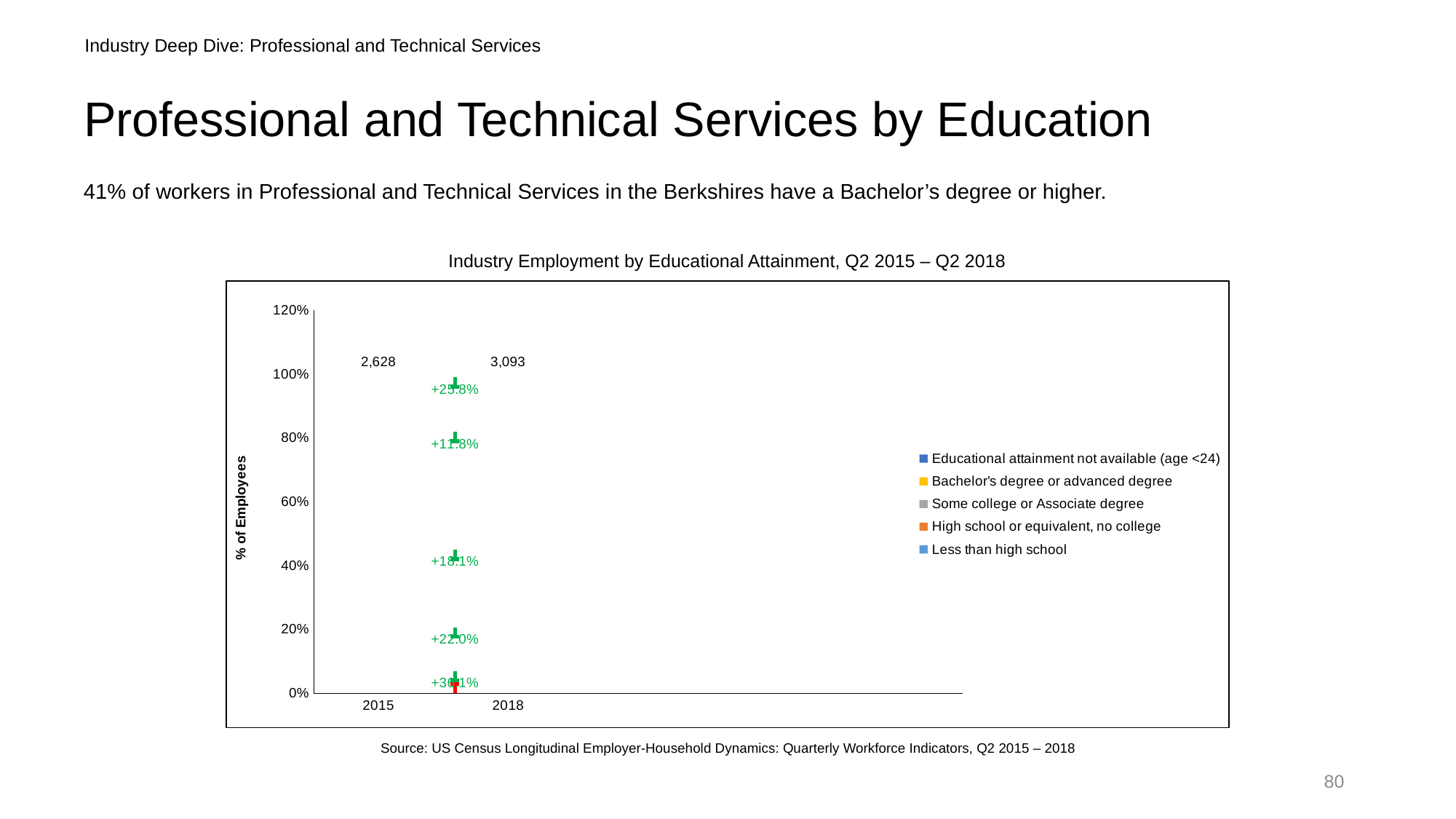
What is the difference between the 2018 total (3,093) and the 2015 total (2,628)? 465 What total employment figure is printed above the 2018 bar? 3,093 Does total employment rise or fall from 2015 to 2018? rise What is the title of the chart? Industry Employment by Educational Attainment, Q2 2015 – Q2 2018 What total employment figure is printed above the 2015 bar? 2,628 Which year has the larger total employment figure, 2015 or 2018? 2018 How many years are shown on the x axis? 2 Which year shows the lowest total employment figure? 2015 How many series does the legend list? 5 Which year shows the highest total employment figure? 2018 What is the label on the y axis? % of Employees